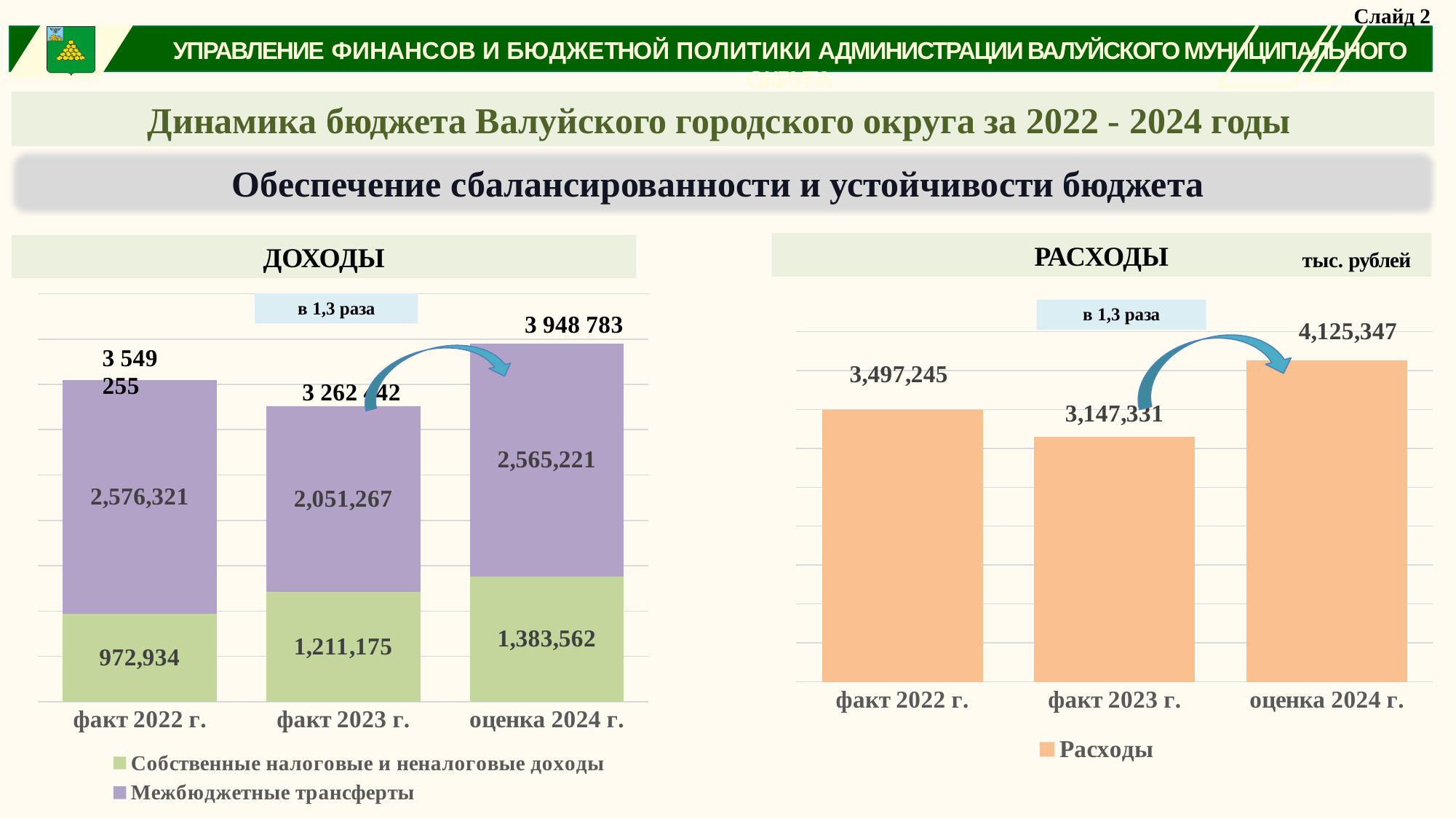
In the ДОХОДЫ chart, what is the value of Межбюджетные трансферты for оценка 2024 г.? 2,565,221 In the ДОХОДЫ chart, what is the difference between Собственные налоговые и неналоговые доходы for факт 2023 г. and факт 2022 г.? 238,241 In the РАСХОДЫ chart, how many categories are shown on the x axis? 3 In the РАСХОДЫ chart, which category has the lowest value? факт 2023 г. In the ДОХОДЫ chart, what is the total of the stacked bar for оценка 2024 г.? 3 948 783 What kind of chart is the РАСХОДЫ chart? bar chart In the ДОХОДЫ chart, what is the value of Межбюджетные трансферты for факт 2023 г.? 2,051,267 In the РАСХОДЫ chart, what is the difference between оценка 2024 г. and факт 2022 г.? 628,102 In the ДОХОДЫ chart, which category has the highest value of Собственные налоговые и неналоговые доходы? оценка 2024 г. In the РАСХОДЫ chart, what is the value of Расходы for факт 2023 г.? 3,147,331 In the ДОХОДЫ chart, how many series does the legend list? 2 In the ДОХОДЫ chart, what is the value of Собственные налоговые и неналоговые доходы for факт 2022 г.? 972,934